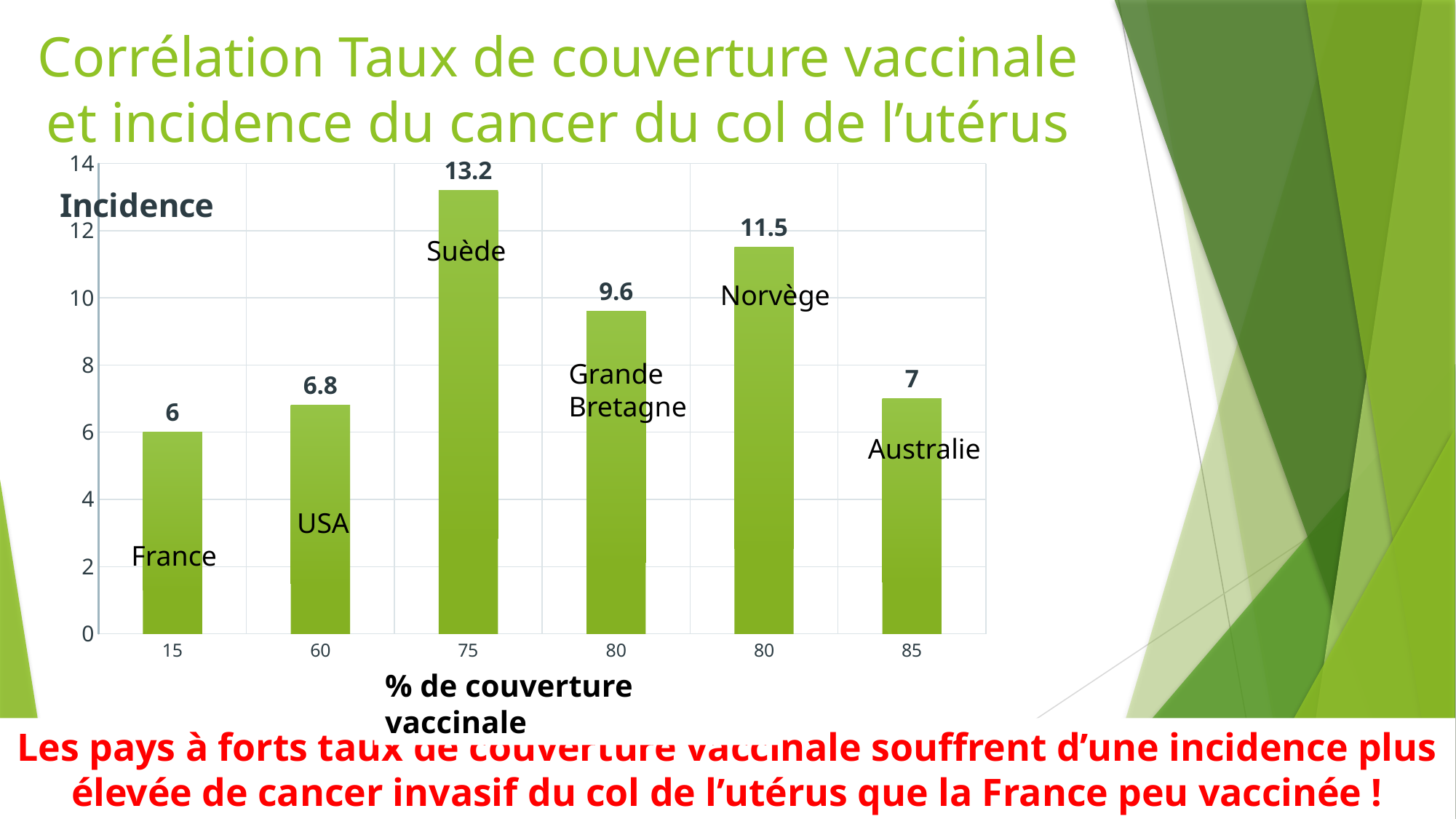
What is the x-axis label of the chart? % de couverture vaccinale What is the difference between the incidence values for Suède and France? 7.2 Which has a higher incidence value, USA or Australie? Australie How many bars are shown in the chart? 6 What is the incidence value shown for France? 6 Which country has the lowest incidence value in the chart? France What is the incidence value shown for Norvège? 11.5 What is the incidence value shown for Suède? 13.2 What type of chart is shown on the slide? Bar chart What is the incidence value shown for Grande Bretagne? 9.6 Which country has the highest incidence value in the chart? Suède What is the difference between the incidence values for Norvège and Australie? 4.5